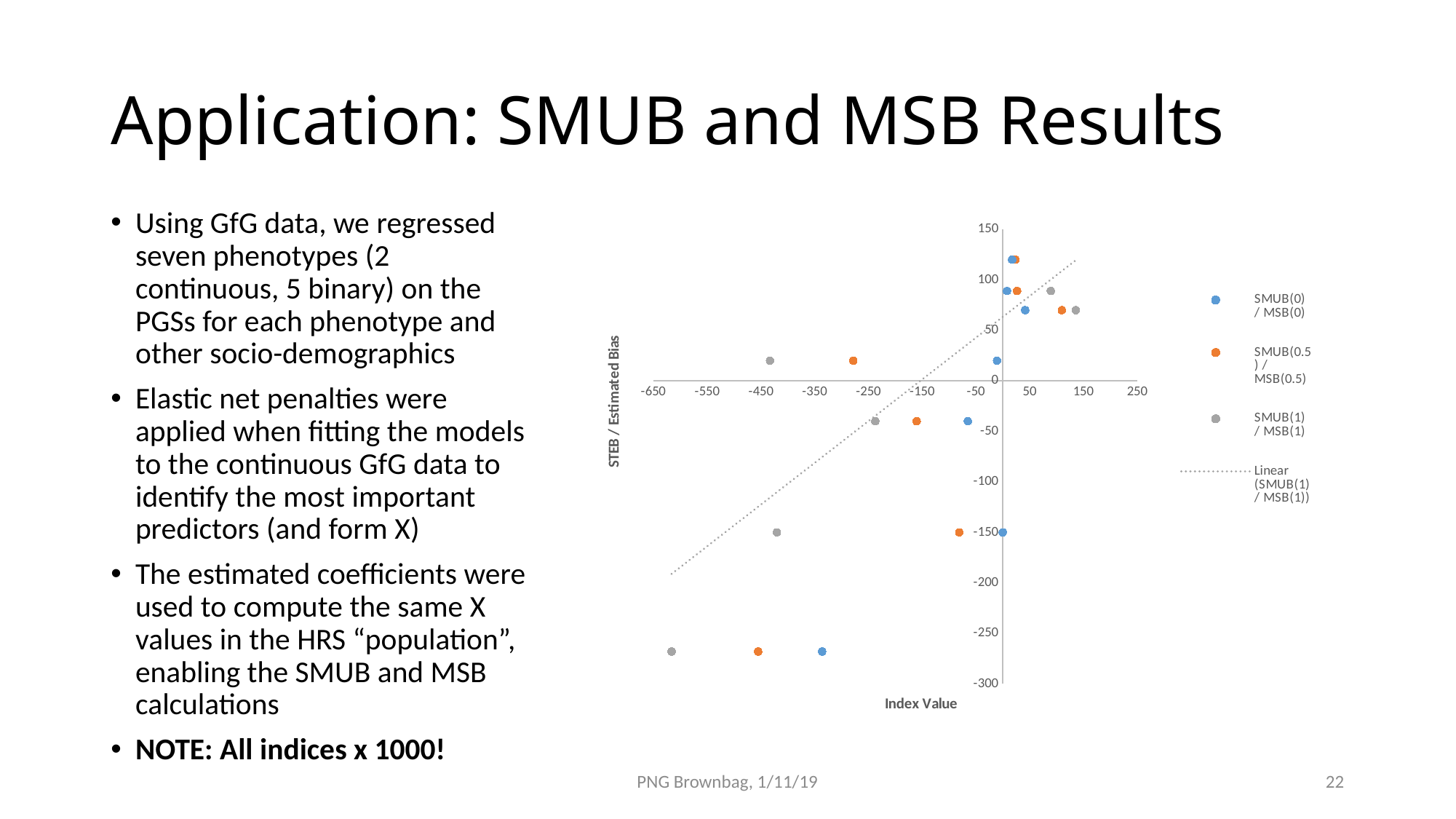
What kind of chart is shown on the slide? Scatter chart Is the lowest plotted STEB / Estimated Bias value on the chart greater or less than -250? less How many points are plotted for the SMUB(0) / MSB(0) series? 7 Which colour marks the SMUB(0.5) / MSB(0.5) series in the chart? Orange Does the dotted linear trendline for SMUB(1) / MSB(1) rise or fall as the Index Value increases? Rises What is the title of the horizontal axis of the chart? Index Value Is the highest plotted STEB / Estimated Bias value on the chart greater or less than 100? greater How many entries does the chart legend list? 4